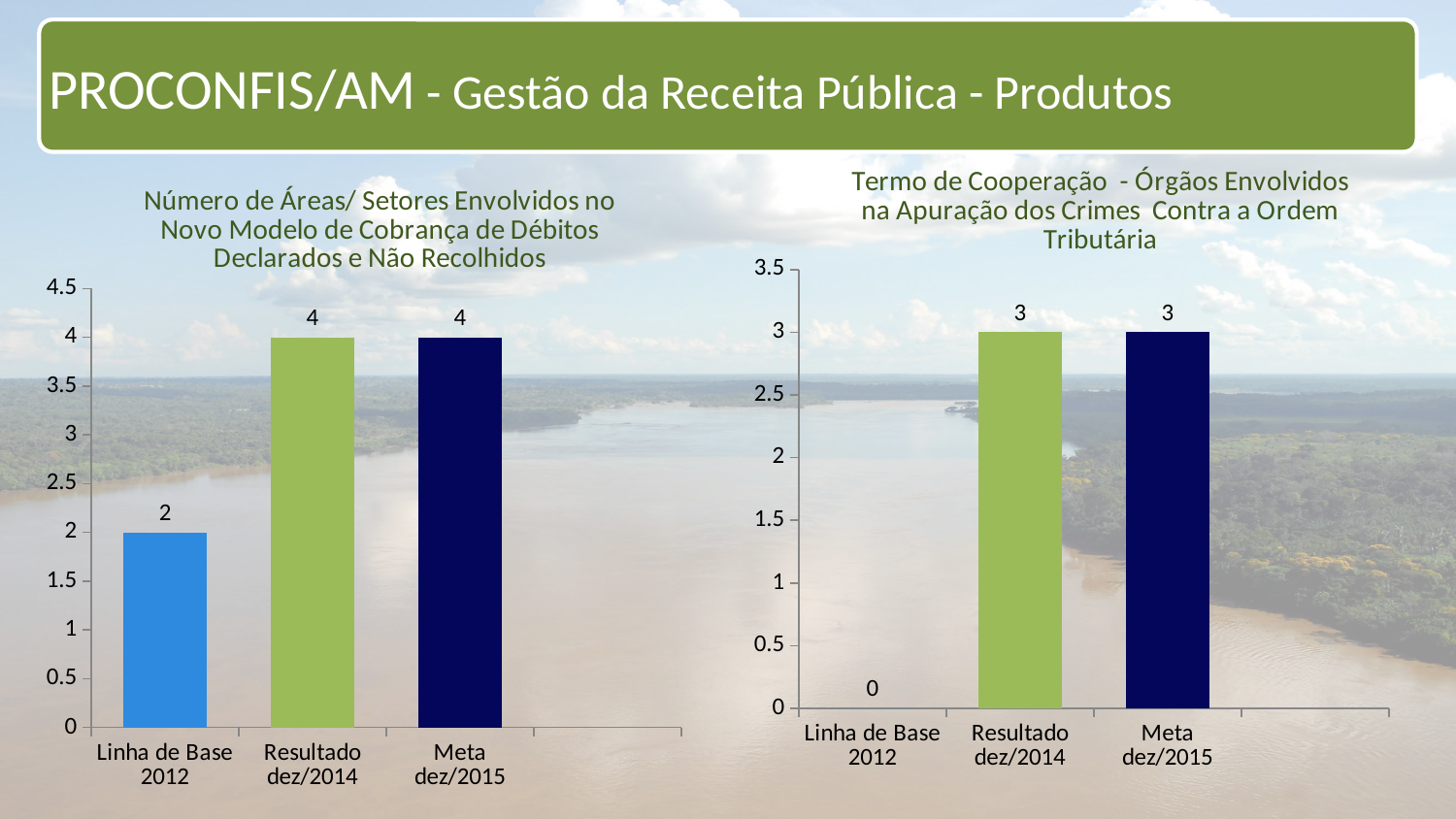
In the right chart (Termo de Cooperação), which category has the lowest value? Linha de Base 2012 In the left chart (Número de Áreas/ Setores Envolvidos), what is the value for Linha de Base 2012? 2 What type of chart is the left chart (Número de Áreas/ Setores Envolvidos)? Bar chart In the right chart (Termo de Cooperação), what is the difference between Resultado dez/2014 and Linha de Base 2012? 3 In the left chart (Número de Áreas/ Setores Envolvidos), which category has the lowest value? Linha de Base 2012 In the left chart (Número de Áreas/ Setores Envolvidos), what is the value for Resultado dez/2014? 4 In the right chart (Termo de Cooperação), what is the value for Linha de Base 2012? 0 In the left chart (Número de Áreas/ Setores Envolvidos), what is the difference between Meta dez/2015 and Linha de Base 2012? 2 In the right chart (Termo de Cooperação), what is the value for Meta dez/2015? 3 In the right chart (Termo de Cooperação), what colour is the bar for Meta dez/2015? Dark navy blue In the left chart (Número de Áreas/ Setores Envolvidos), how many categories are shown on the x axis? 3 In the right chart (Termo de Cooperação), which is larger: Resultado dez/2014 or Linha de Base 2012? Resultado dez/2014